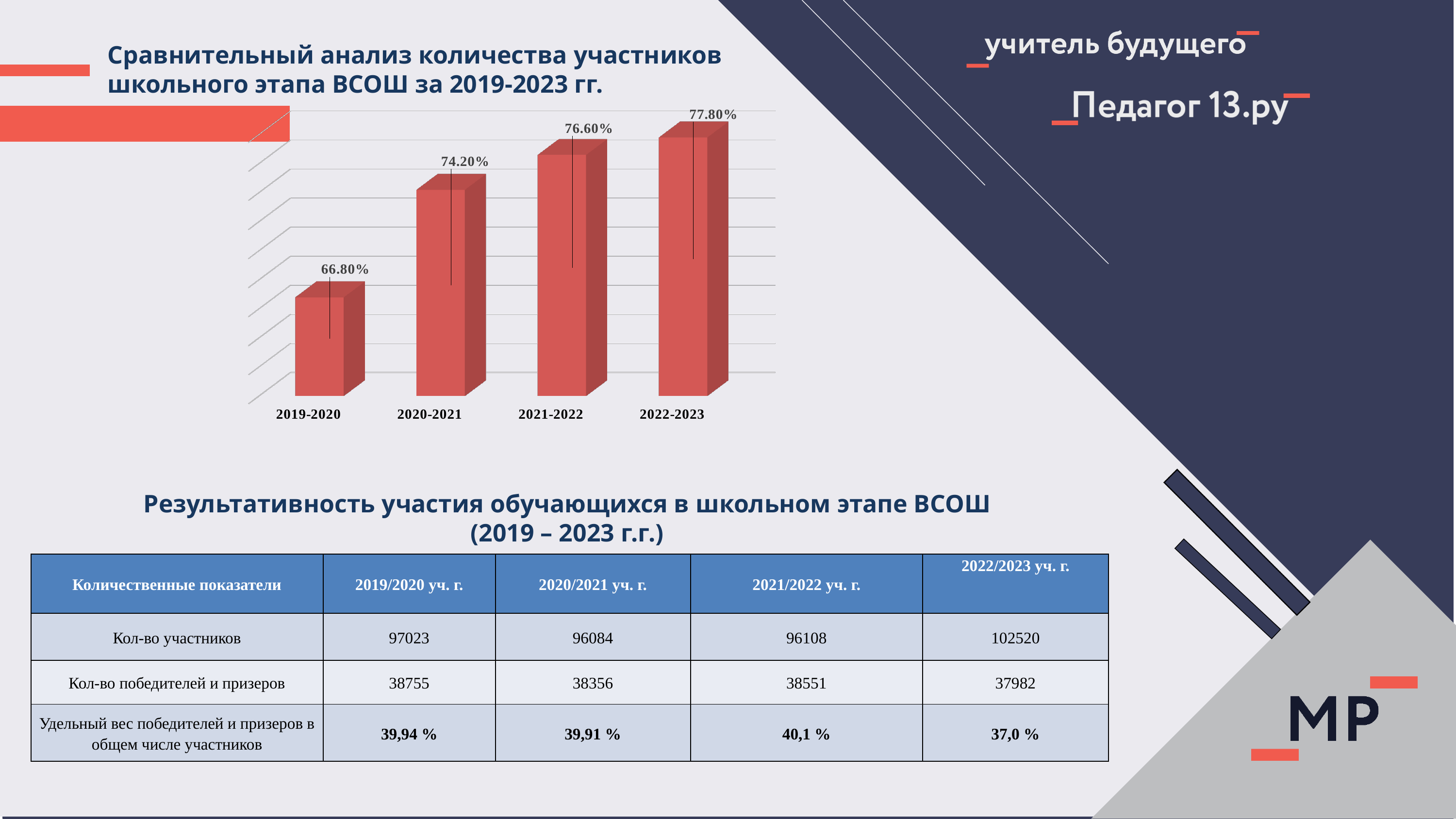
What is the value for 2019-2020 in the bar chart? 66.80% What is the value for 2022-2023 in the bar chart? 77.80% Do the values in the bar chart rise or fall from 2019-2020 to 2022-2023? Rise What kind of chart is shown on the slide? Bar chart Which academic year has the highest value in the bar chart? 2022-2023 What is the value for 2021-2022 in the bar chart? 76.60% Which academic year has the lowest value in the bar chart? 2019-2020 What is the difference between the values for 2020-2021 and 2019-2020 in the bar chart? 7.40% How many academic years are shown in the bar chart? 4 What is the value for 2020-2021 in the bar chart? 74.20% Which is larger in the bar chart: the value for 2020-2021 or the value for 2021-2022? 2021-2022 What is the difference between the values for 2022-2023 and 2019-2020 in the bar chart? 11.00%